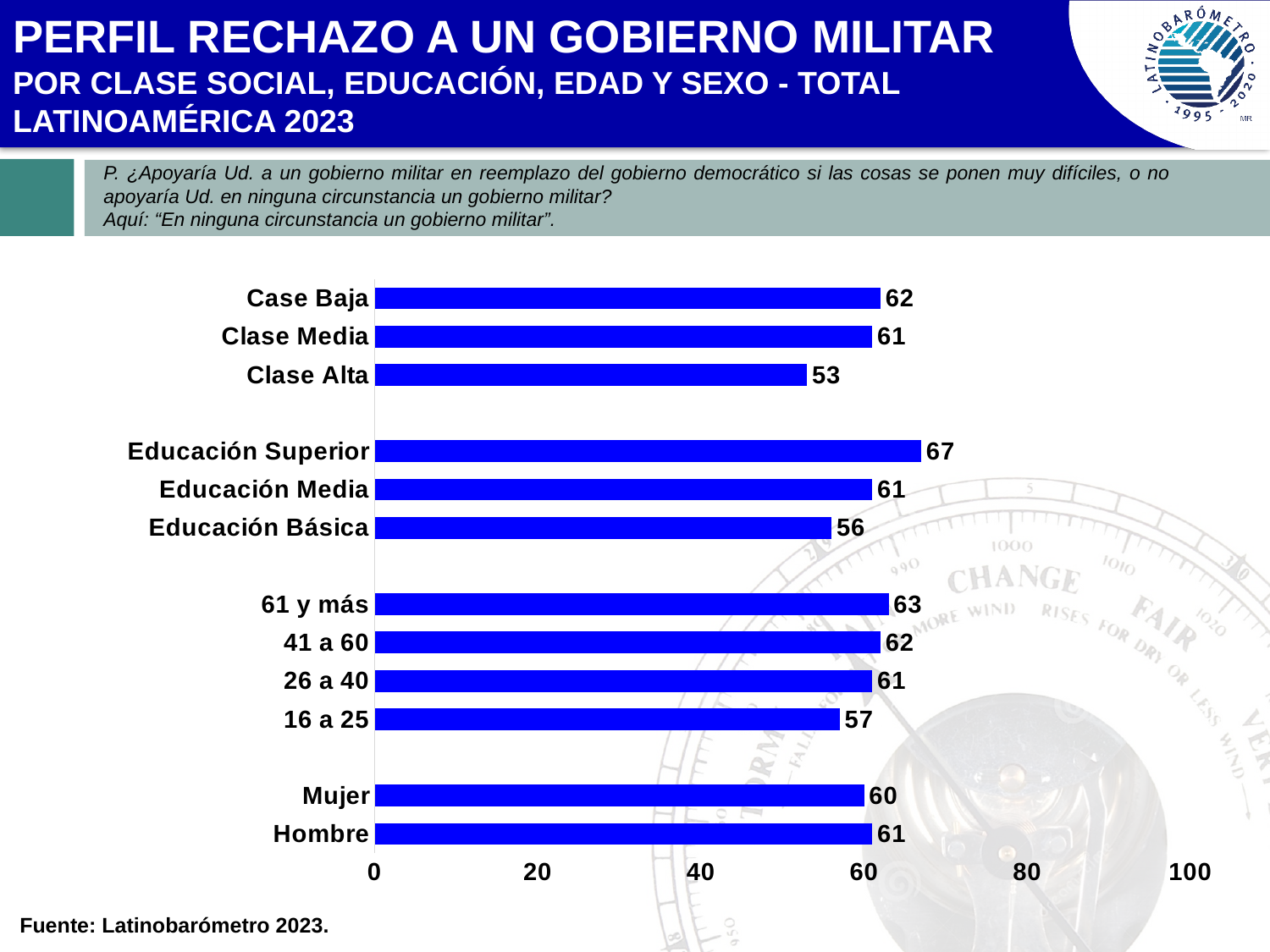
Which is larger, the value for 61 y más or the value for 16 a 25? 61 y más What is the value for Educación Superior? 67 What is the value for Mujer? 60 What is the source cited below the chart? Latinobarómetro 2023 What kind of chart is shown on the slide? bar chart How many categories are plotted in the chart? 12 What is the difference between the values for Educación Superior and Educación Básica? 11 Is the value for Clase Alta greater or less than 60? less What is the value for 16 a 25? 57 Which category has the highest value? Educación Superior Which category has the lowest value? Clase Alta What is the value for Clase Alta? 53